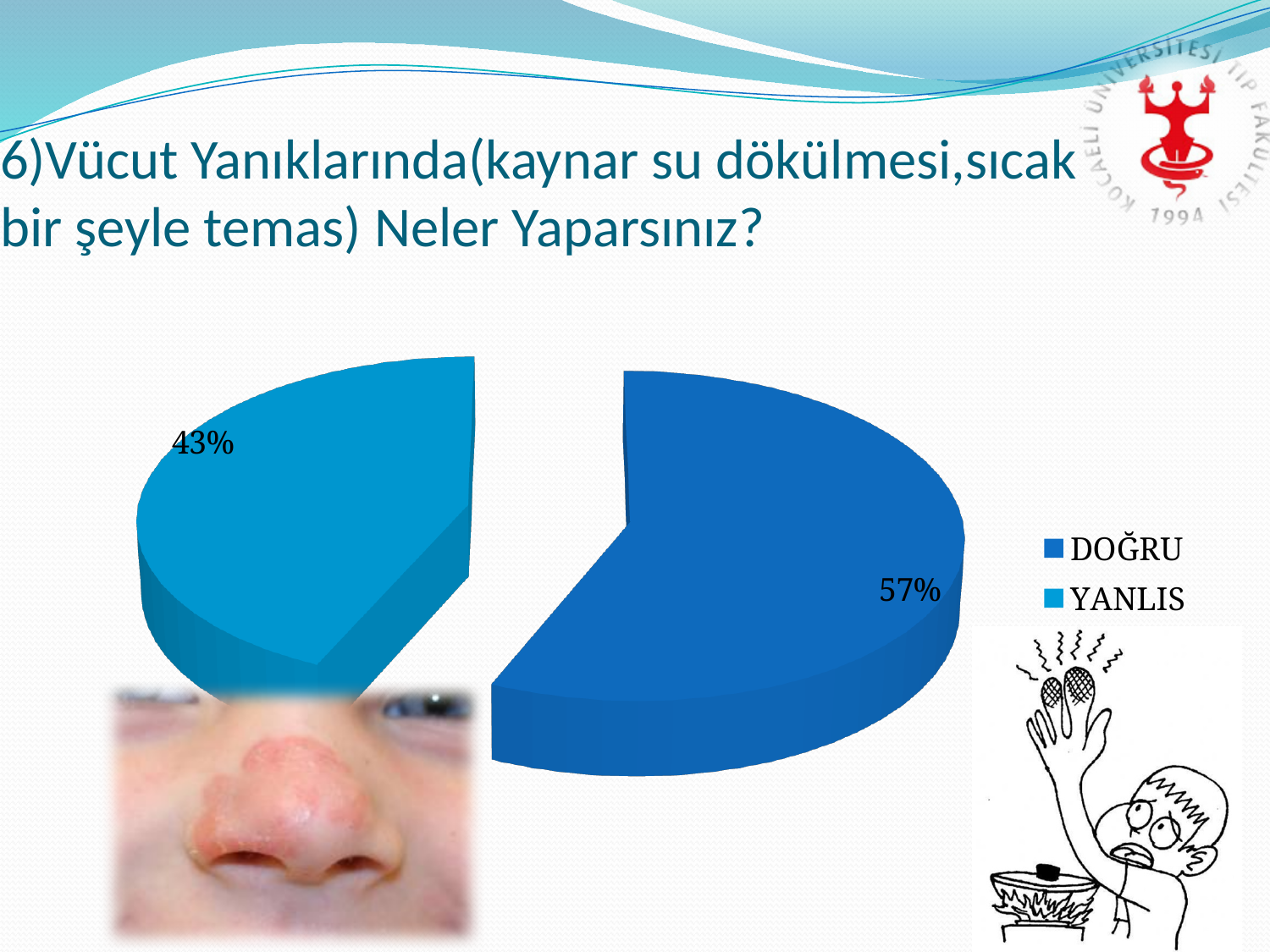
How many slices does the pie chart have? 2 What is the difference in percentage points between the DOĞRU and YANLIS slices? 14 How many entries does the legend list? 2 What percentage of the pie is labelled DOĞRU? 57% Is the share for YANLIS greater or less than 50%? less Which slice of the pie is the smallest? YANLIS What kind of chart is shown on the slide? pie chart What percentage of the pie is labelled YANLIS? 43% Which legend entry is shown in the lighter blue colour? YANLIS Which is larger, the DOĞRU slice or the YANLIS slice? DOĞRU What share of the pie does the DOĞRU slice take? 57% Which slice of the pie is the largest? DOĞRU